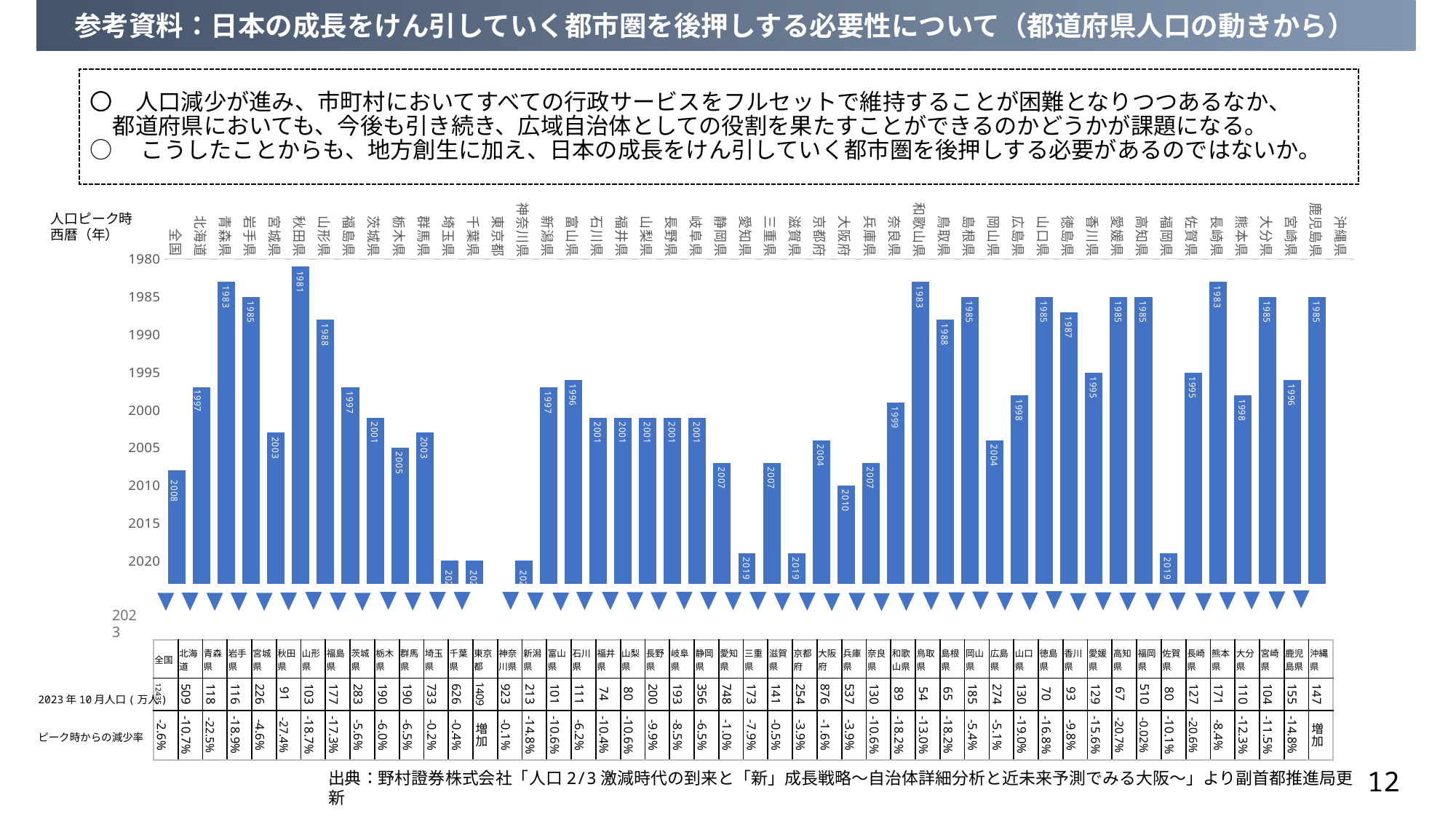
How many years apart are the peak years of 大阪府 and 秋田県? 29 According to the table under the chart, what is the 2023年10月人口 (万人) for 大阪府? 876 Which prefecture has the earliest population peak year in the chart? 秋田県 Is the peak year for 京都府 before or after 2000? after What is the population peak year shown for 大阪府? 2010 Which has the later population peak year, 北海道 or 青森県? 北海道 What is the population peak year shown for 秋田県? 1981 What is the population peak year shown for 愛知県? 2019 What is the population peak year shown for 和歌山県? 1983 What is the population peak year shown for 全国? 2008 How many categories are shown along the x axis of the chart? 48 What kind of chart is shown on the slide? bar chart